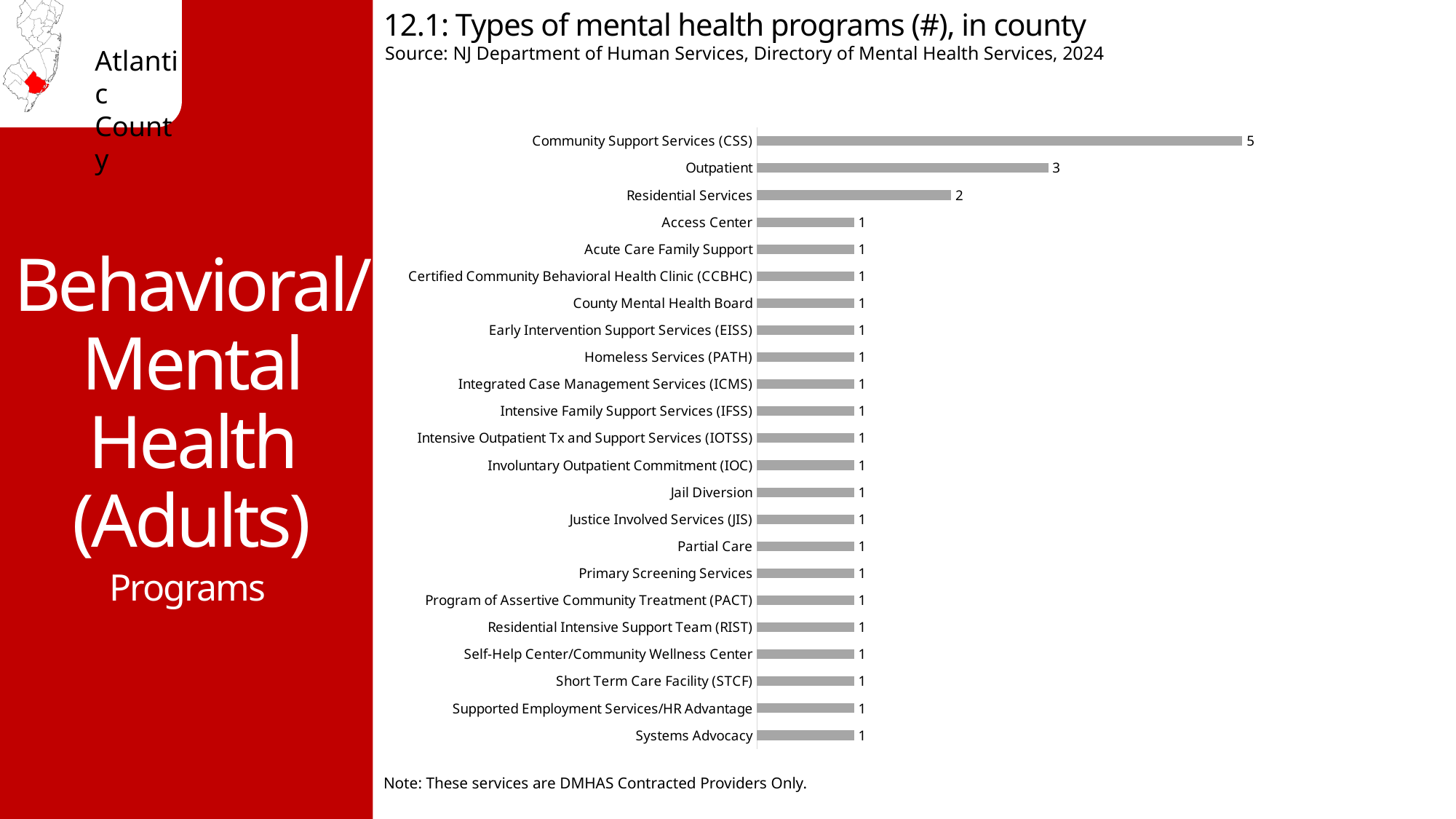
What is the difference between the values for Outpatient and Residential Services? 1 What is the title of the chart? 12.1: Types of mental health programs (#), in county What is the value for Program of Assertive Community Treatment (PACT)? 1 Which category has the highest value? Community Support Services (CSS) What is the difference between the values for Community Support Services (CSS) and Outpatient? 2 What kind of chart is shown on the slide? Bar chart Which is larger, the value for Residential Services or the value for Jail Diversion? Residential Services What is the value for Residential Services? 2 Which is larger, the value for Outpatient or the value for Residential Services? Outpatient What is the value for Outpatient? 3 How many categories are shown in the chart? 23 What is the value for Community Support Services (CSS)? 5